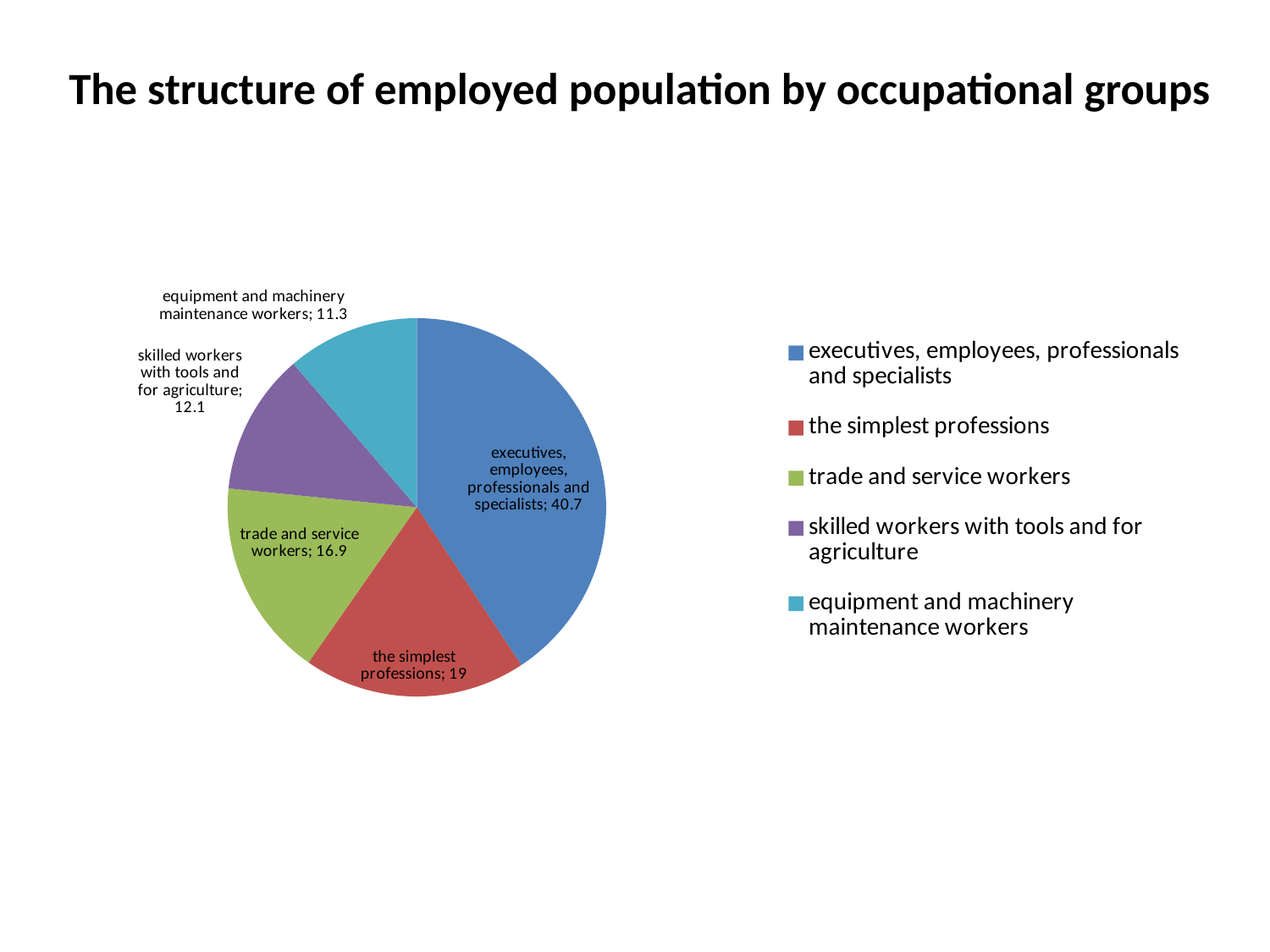
What is the difference between the values for executives, employees, professionals and specialists and the simplest professions? 21.7 Which occupational group has the largest slice of the pie? executives, employees, professionals and specialists What is the value for executives, employees, professionals and specialists? 40.7 Which is larger: the value for skilled workers with tools and for agriculture or the value for equipment and machinery maintenance workers? skilled workers with tools and for agriculture What is the title of the slide? The structure of employed population by occupational groups What is the value for the simplest professions? 19 What is the value for equipment and machinery maintenance workers? 11.3 How many slices does the pie chart have? 5 Which occupational group has the smallest slice of the pie? equipment and machinery maintenance workers What kind of chart is shown on the slide? pie chart What is the difference between the values for the simplest professions and trade and service workers? 2.1 What is the value for trade and service workers? 16.9